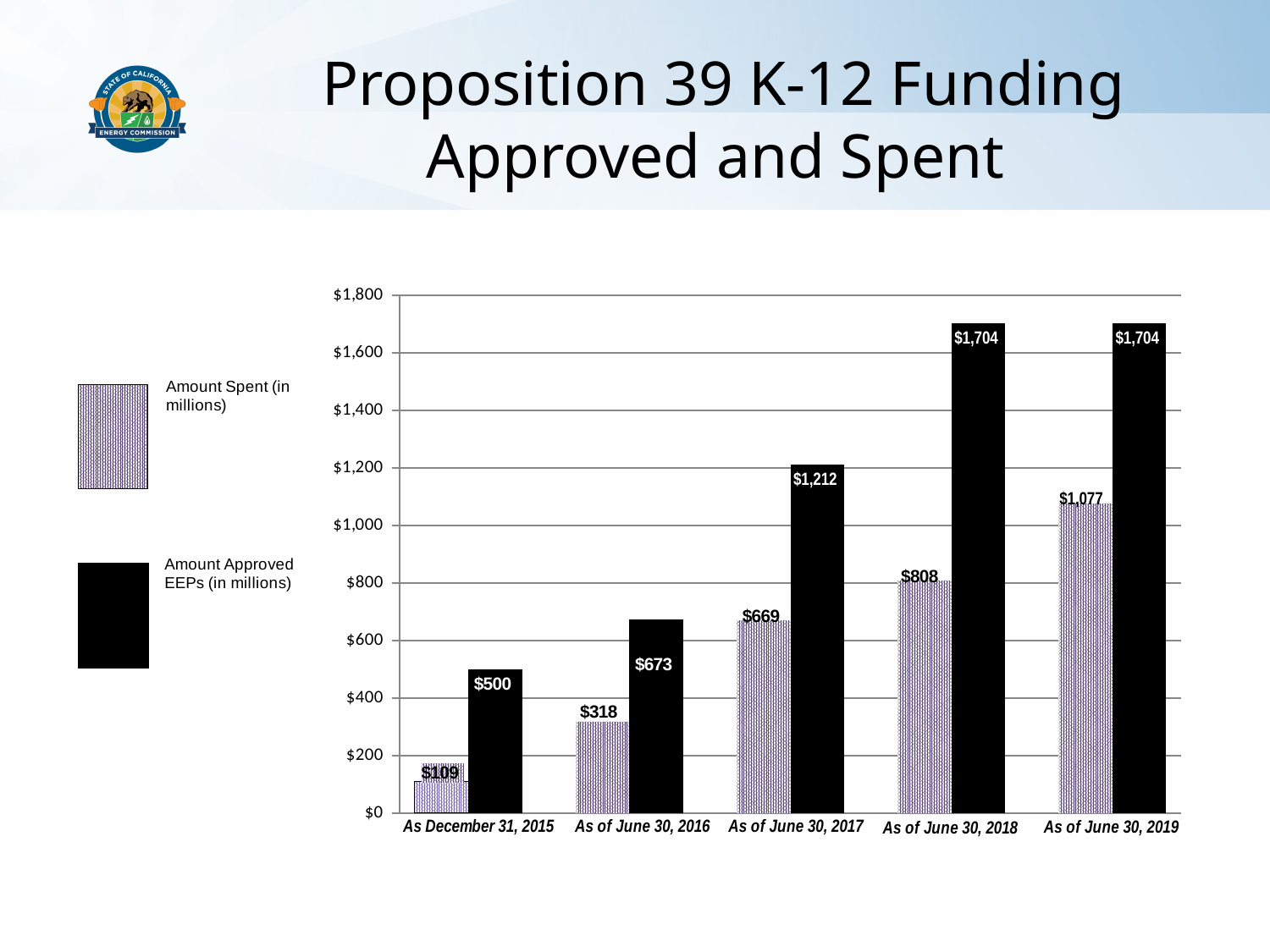
What is the difference between Amount Approved EEPs and Amount Spent as of June 30, 2018? $896 What is the Amount Spent (in millions) as of June 30, 2019? $1,077 Is the Amount Approved EEPs as of June 30, 2017 greater or less than $1,000? greater How many series does the legend list? 2 Does the Amount Spent (in millions) rise or fall from December 31, 2015 to June 30, 2019? rise Which period has the lowest Amount Spent (in millions)? As December 31, 2015 Which is larger as of June 30, 2016: Amount Spent or Amount Approved EEPs? Amount Approved EEPs How many time periods are shown on the x axis? 5 What kind of chart is shown on the slide? bar chart What is the Amount Spent (in millions) as of June 30, 2017? $669 Which period has the highest Amount Spent (in millions)? As of June 30, 2019 What is the Amount Approved EEPs (in millions) as of June 30, 2016? $673